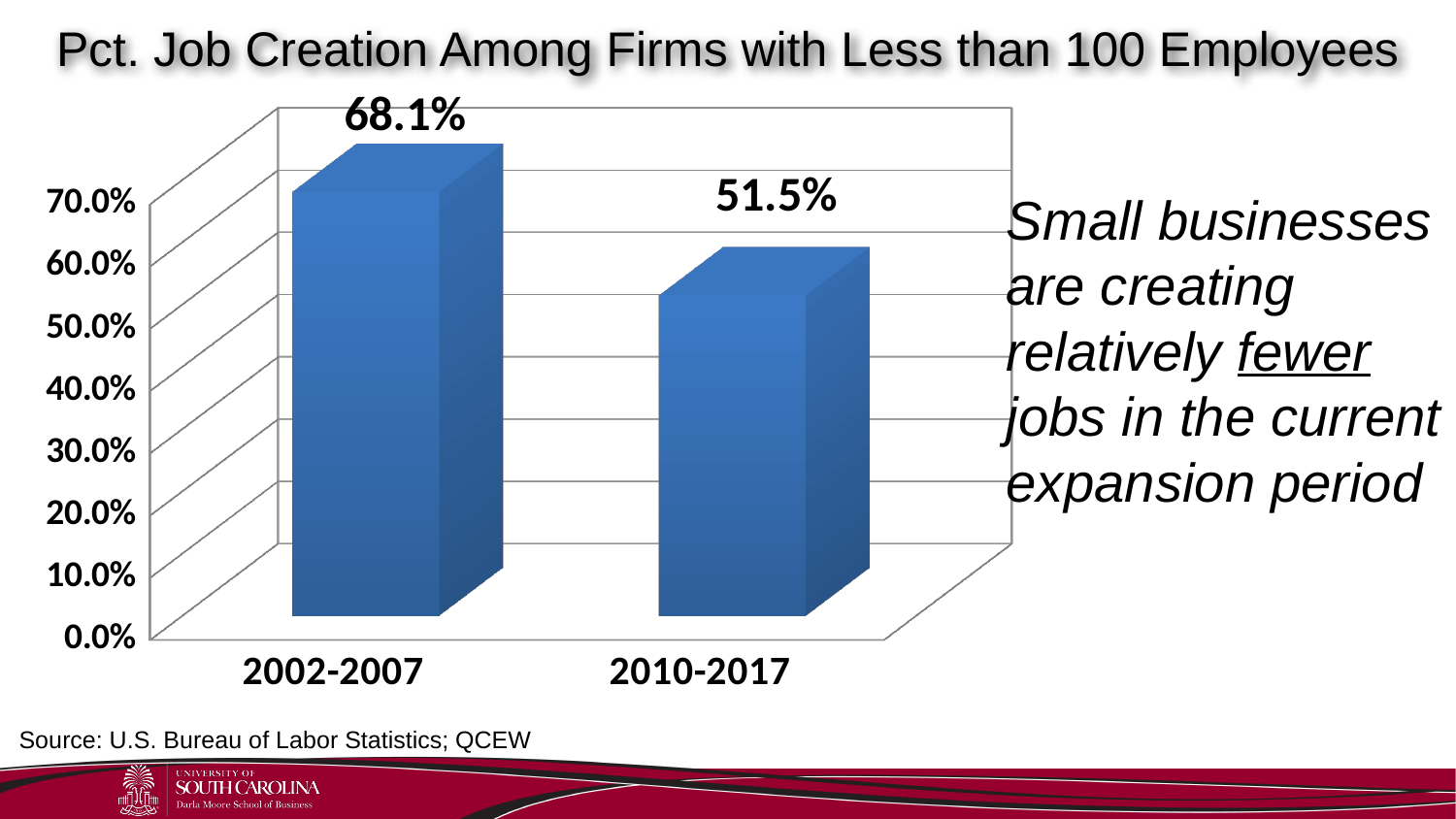
What is the percentage of job creation among firms with less than 100 employees for 2010-2017? 51.5% Which period has the lower percentage of job creation among small firms? 2010-2017 What is the title of the chart? Pct. Job Creation Among Firms with Less than 100 Employees Which period has the higher percentage of job creation among small firms? 2002-2007 Is the value for 2002-2007 greater or less than 60.0%? greater Do the values rise or fall from 2002-2007 to 2010-2017? fall Is the value for 2010-2017 greater or less than the value for 2002-2007? less What is the percentage of job creation among firms with less than 100 employees for 2002-2007? 68.1% How many time periods are shown on the chart? 2 What is the difference in percentage points between the 2002-2007 and 2010-2017 values? 16.6 What kind of chart is shown on the slide? bar chart Is the value for 2010-2017 greater or less than 60.0%? less